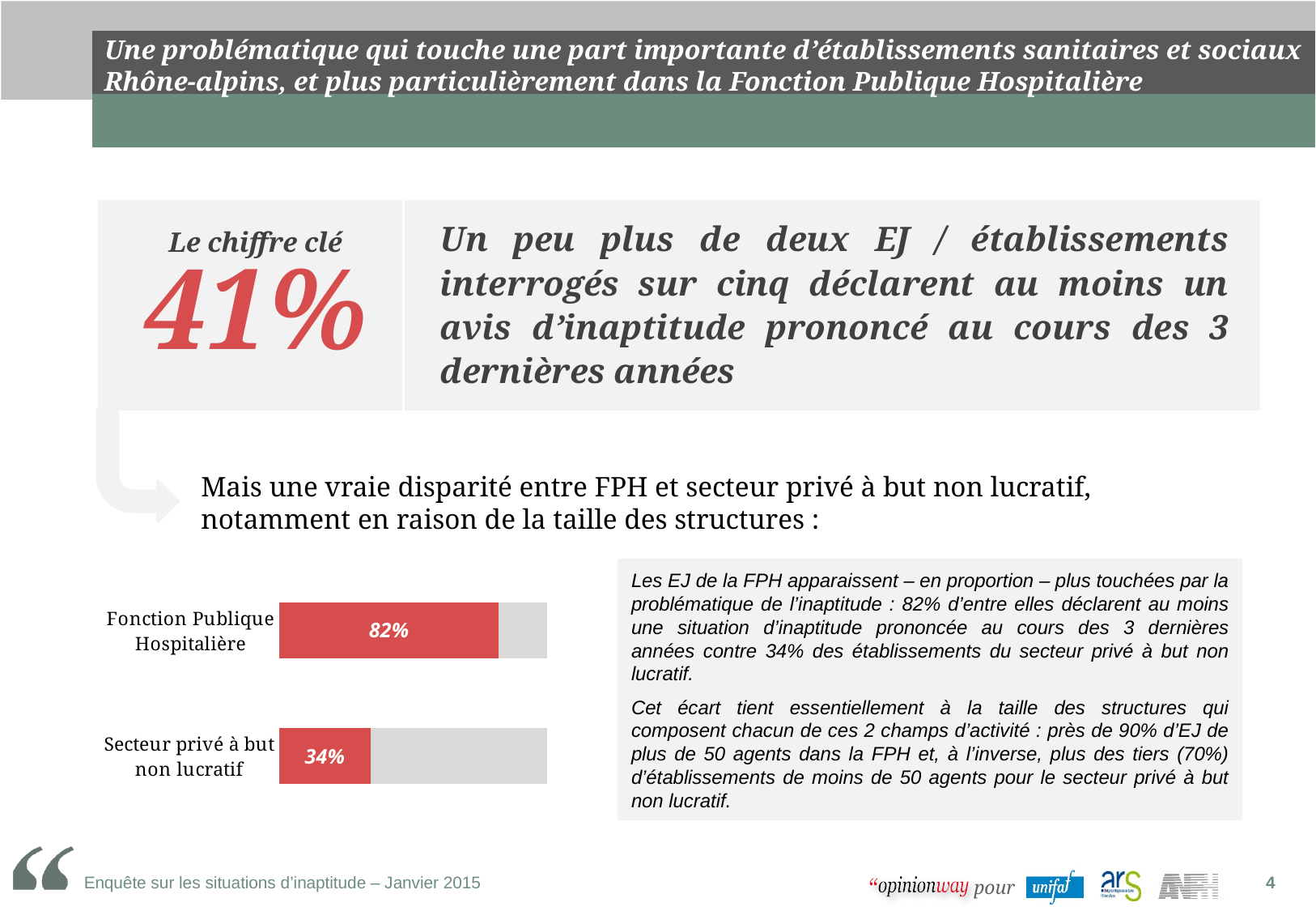
How many categories are shown in the chart? 2 Which is larger, the value for Fonction Publique Hospitalière or the value for Secteur privé à but non lucratif? Fonction Publique Hospitalière Which category has the highest value? Fonction Publique Hospitalière What is the value for Secteur privé à but non lucratif? 34% What is the value for Fonction Publique Hospitalière? 82% What colour are the bars showing the values in the chart? red What kind of chart is shown on the slide? bar chart Are the bars in the chart horizontal or vertical? horizontal What is the difference between the values for Fonction Publique Hospitalière and Secteur privé à but non lucratif? 48% Which category has the lowest value? Secteur privé à but non lucratif